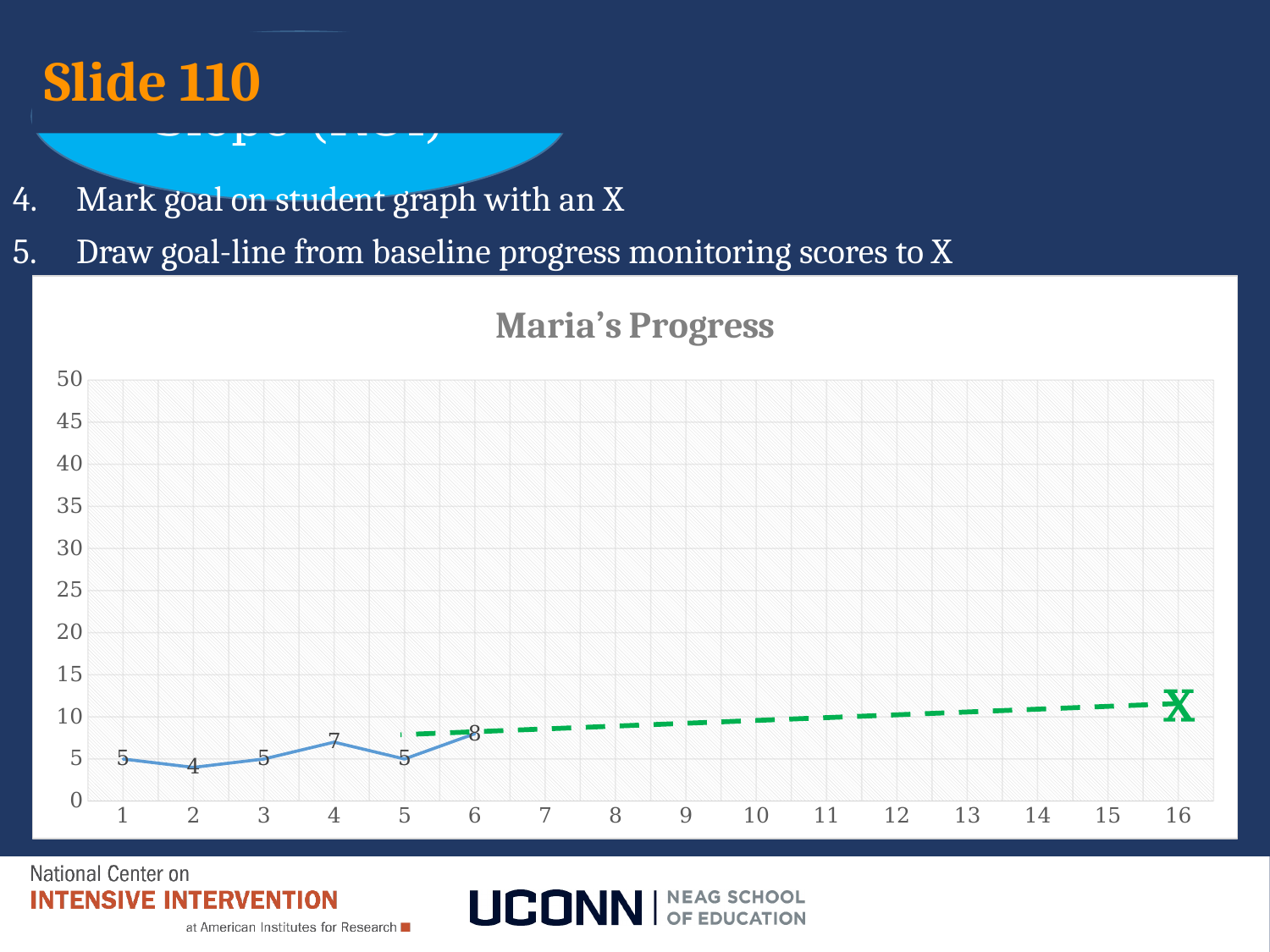
How many data points are plotted on Maria's progress line? 6 Which is larger, Maria's score at point 4 or at point 5? point 4 At which point is Maria's score the highest? 6 At which point is Maria's score the lowest? 2 What is the difference between Maria's score at point 6 and her score at point 2? 4 What is Maria's score at point 4? 7 What is Maria's score at point 6? 8 What is Maria's score at point 1? 5 What type of chart is shown on the slide? line chart What is Maria's score at point 2? 4 What is the title of the chart? Maria's Progress